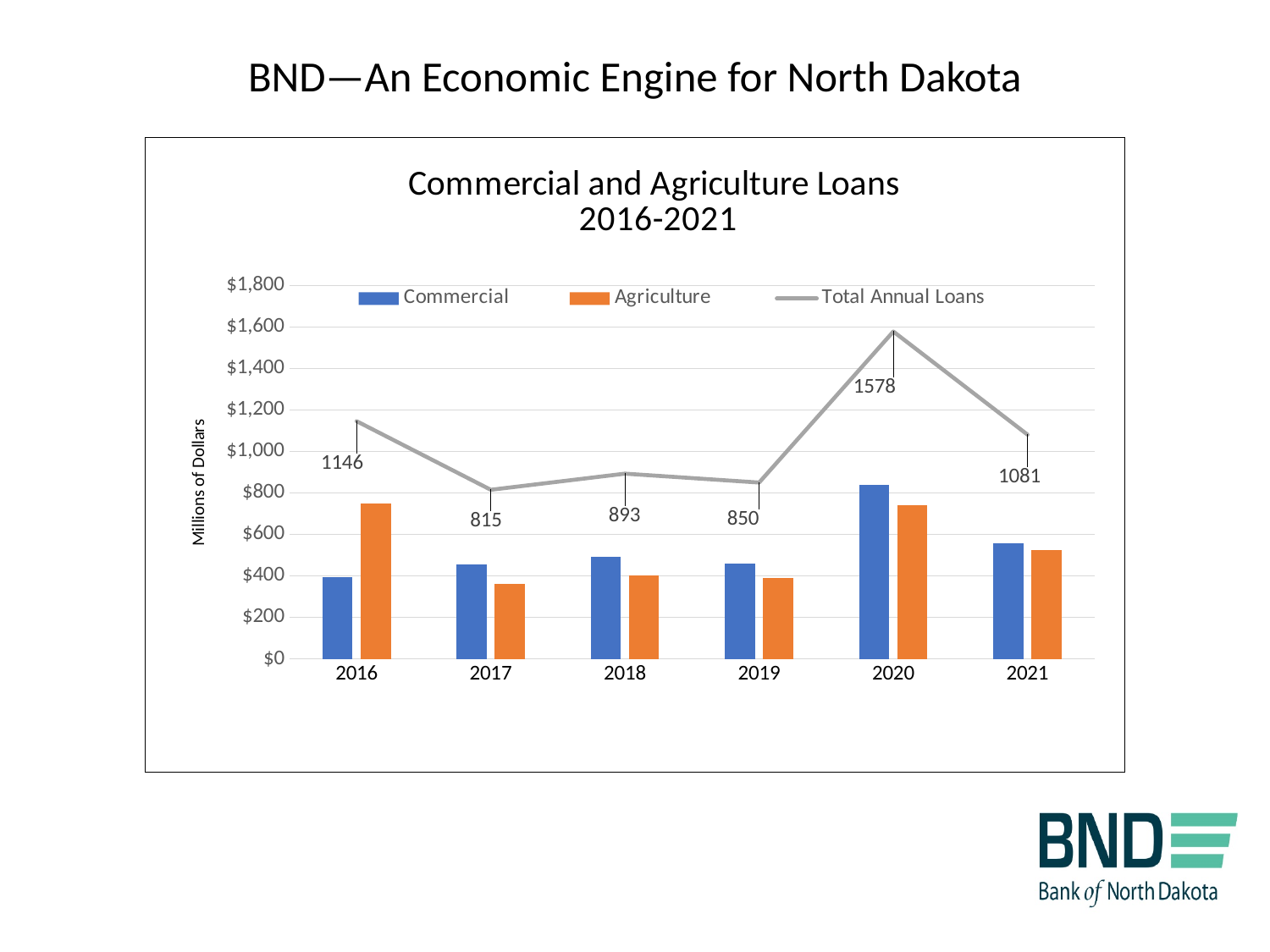
Is the Agriculture value for 2016 greater or less than $600? greater What is the Total Annual Loans value for 2020? 1578 Which year has the highest Total Annual Loans? 2020 What is the label on the vertical axis? Millions of Dollars Which year has the lowest Total Annual Loans? 2017 What is the Total Annual Loans value for 2016? 1146 What is the Total Annual Loans value for 2017? 815 Is the Commercial value for 2016 greater or less than $600? less How many series does the legend list? 3 Which year has the larger Total Annual Loans, 2018 or 2019? 2018 What is the difference between the Total Annual Loans for 2020 and 2021? 497 How many years are shown on the x axis? 6